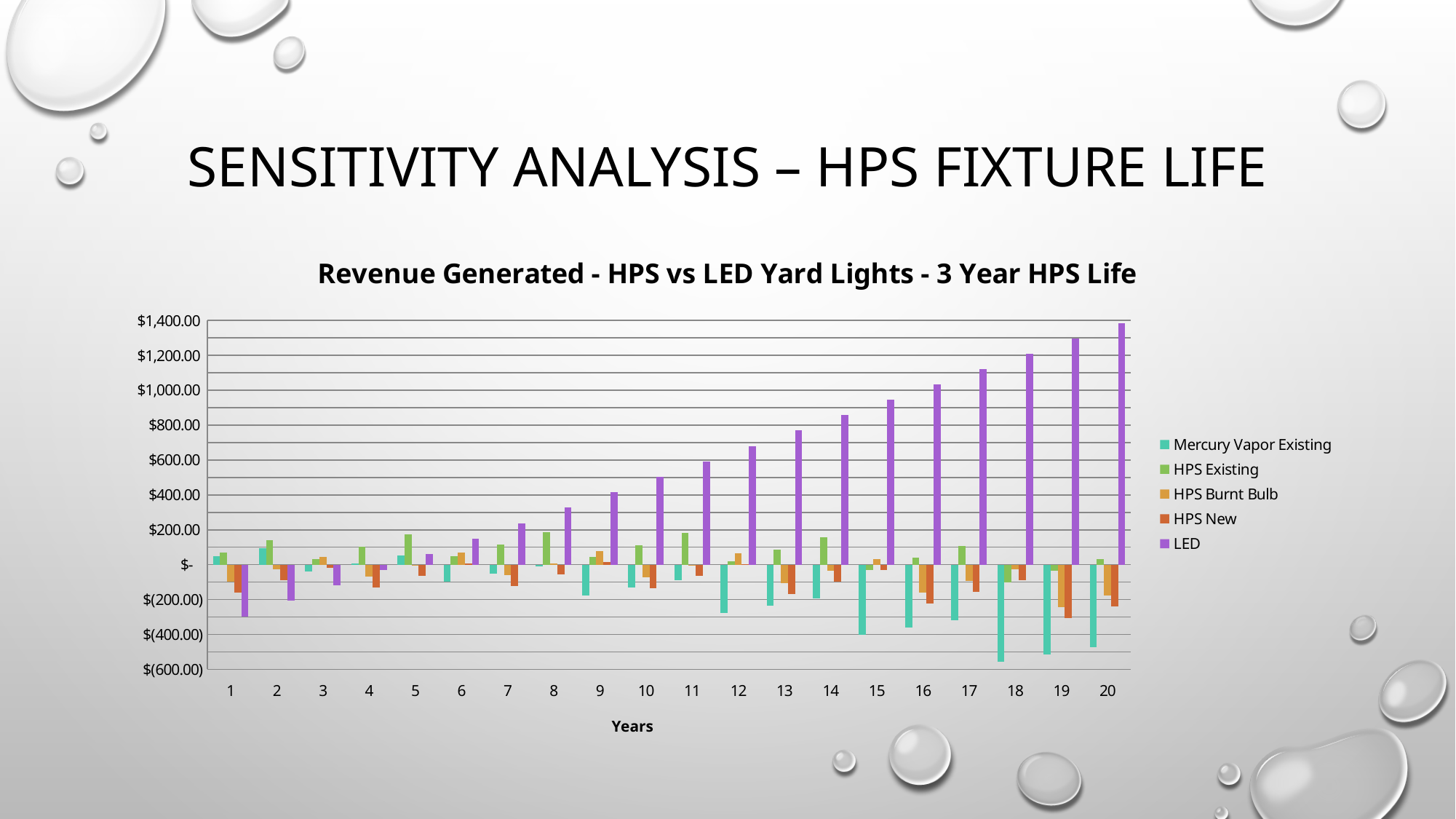
What kind of chart is shown on the slide? bar chart Which series has the tallest bar at year 20? LED How many series does the legend list? 5 Which is larger, the LED value for year 10 or the LED value for year 20? year 20 What is the label of the x axis? Years Do the LED values rise or fall as the years increase? rise In which year is the LED value highest? 20 How many years are shown along the x axis? 20 Is the LED value for year 15 greater or less than $800.00? greater What is the title of the chart? Revenue Generated - HPS vs LED Yard Lights - 3 Year HPS Life Is the Mercury Vapor Existing value for year 18 greater or less than $(400.00)? less Is the LED value for year 20 greater or less than $1,200.00? greater